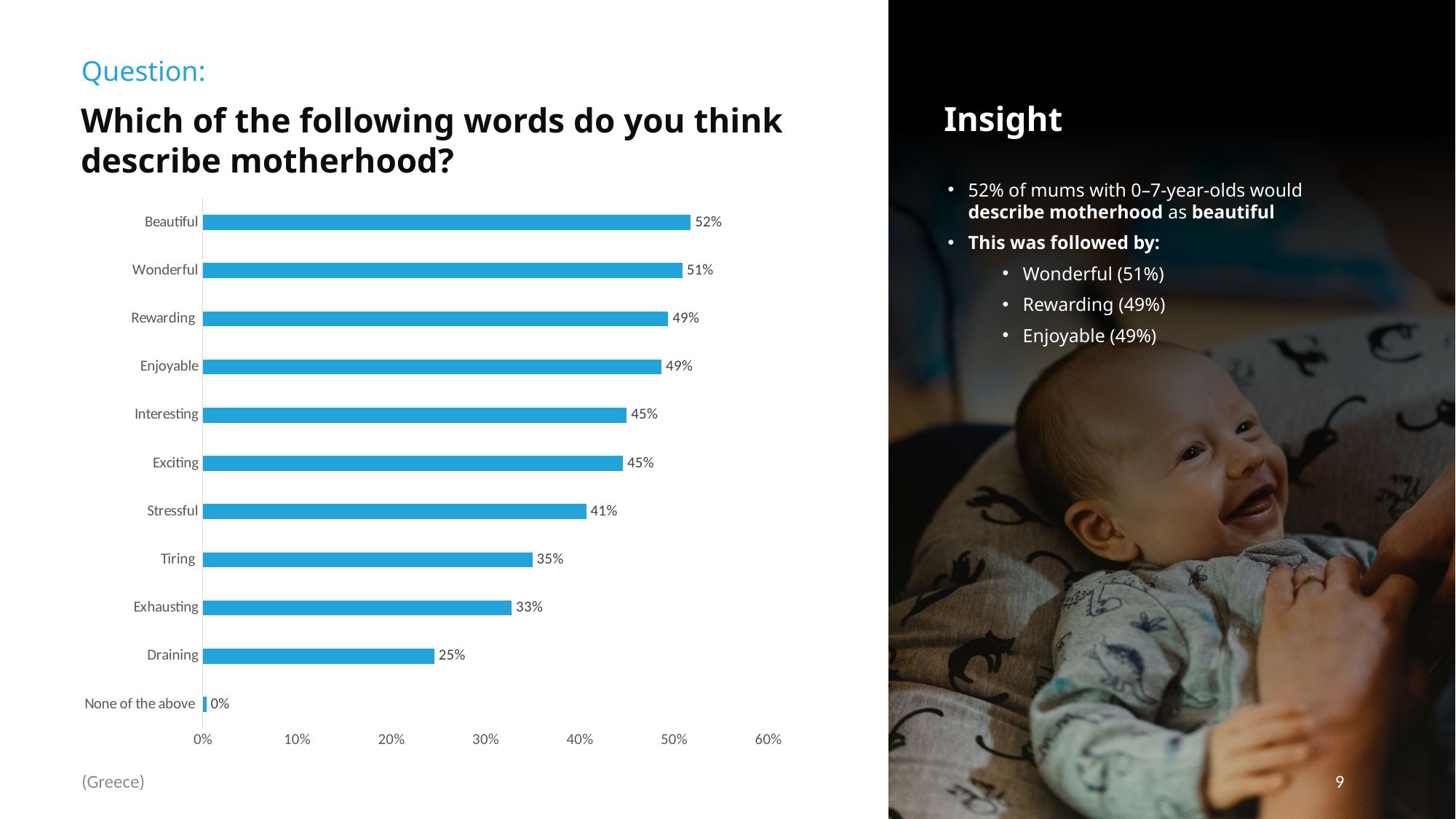
What is the difference between the values for "Wonderful" and "Tiring"? 16% What is the value shown for "Draining"? 25% Which category has the lowest value in the chart? None of the above What kind of chart is shown on the slide? Bar chart What percentage of respondents chose "Beautiful" to describe motherhood? 52% What is the value shown for "Stressful"? 41% How many categories are shown in the chart? 11 What is the highest value shown on the x axis of the chart? 60% What is the difference between the values for "Beautiful" and "Draining"? 27% Which has a higher value, "Exhausting" or "Stressful"? Stressful Is the value for "Interesting" greater or less than 40%? greater Which word has the highest percentage in the chart? Beautiful